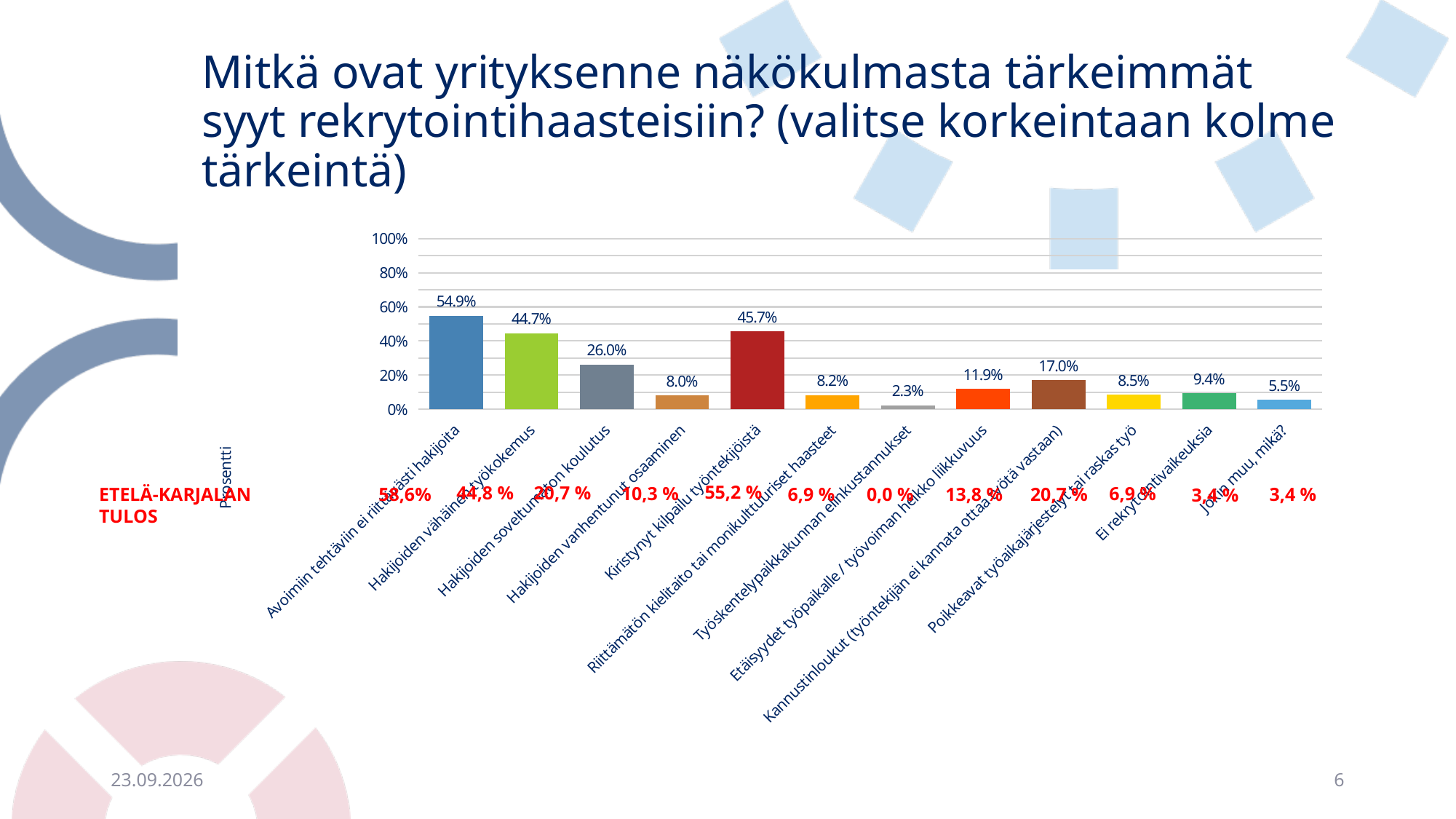
Which category has the lowest value? Työskentelypaikkakunnan elinkustannukset Which is larger, the value for "Hakijoiden soveltumaton koulutus" or the value for "Kannustinloukut (työntekijän ei kannata ottaa työtä vastaan)"? Hakijoiden soveltumaton koulutus What is the difference between the values for "Avoimiin tehtäviin ei riittävästi hakijoita" and "Hakijoiden vähäinen työkokemus"? 10.2% What is the value for "Ei rekrytointivaikeuksia"? 9.4% What is the value for "Kiristynyt kilpailu työntekijöistä"? 45.7% What kind of chart is shown on the slide? bar chart What is the label on the vertical axis of the chart? Prosentti What is the value for "Avoimiin tehtäviin ei riittävästi hakijoita"? 54.9% Is the value for "Hakijoiden vähäinen työkokemus" greater or less than 40%? greater How many categories are shown in the chart? 12 What is the value for "Työskentelypaikkakunnan elinkustannukset"? 2.3% Which category has the highest value? Avoimiin tehtäviin ei riittävästi hakijoita